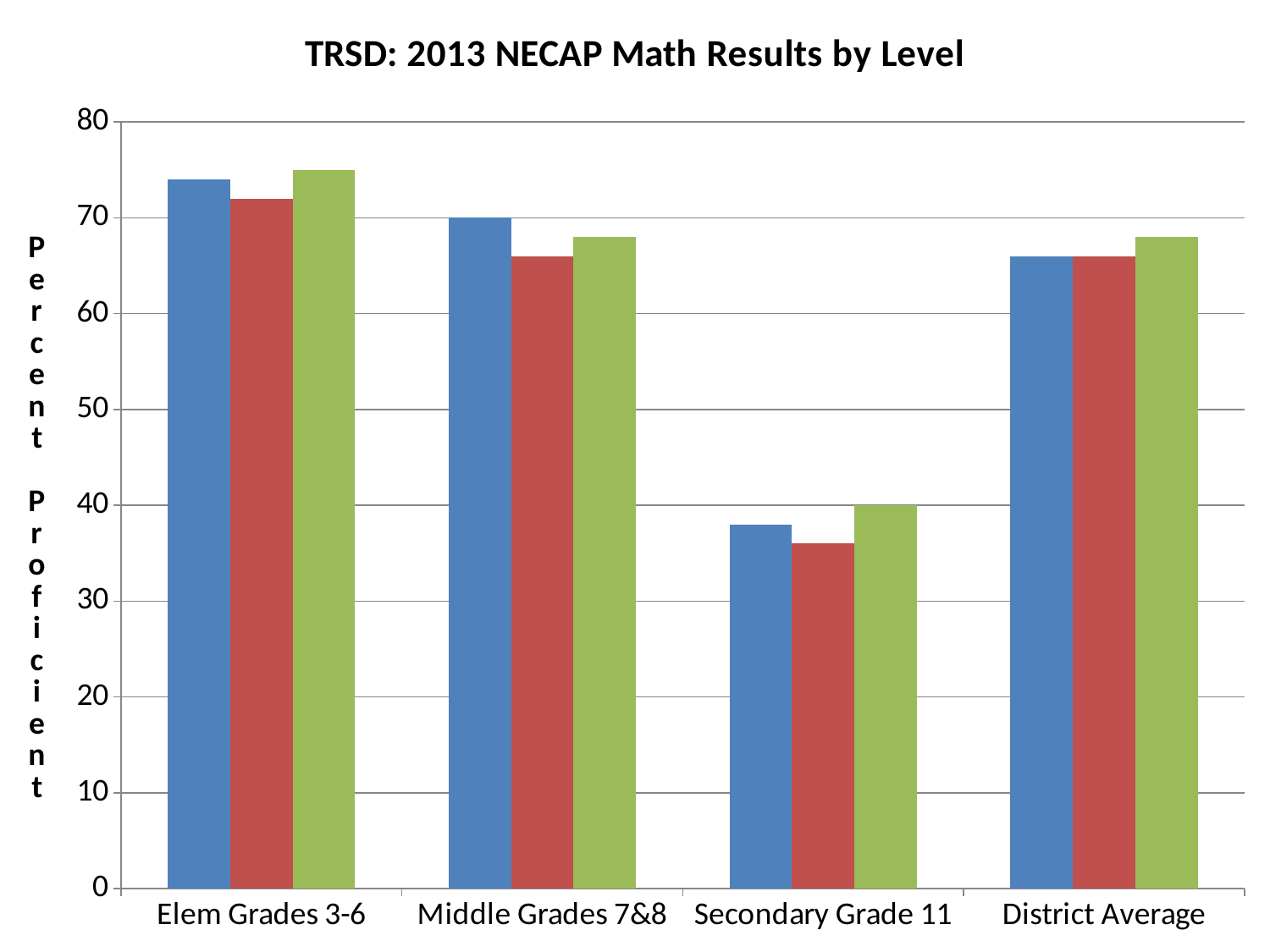
Which is larger: the blue bar for Elem Grades 3-6 or the blue bar for Secondary Grade 11? Elem Grades 3-6 What is the value of the green bar for Secondary Grade 11? 40 Is the value of the blue bar for Elem Grades 3-6 greater or less than 70? greater Is the value of the green bar for District Average greater or less than 70? less Is the value of the red bar for Secondary Grade 11 greater or less than 40? less How many bars are shown for each category? 3 What kind of chart is shown on the slide? bar chart What is the title of the chart? TRSD: 2013 NECAP Math Results by Level Which category has the lowest bars overall? Secondary Grade 11 Which category has the highest bars overall? Elem Grades 3-6 How many categories are shown on the x axis? 4 What is the value of the blue bar for Middle Grades 7&8? 70